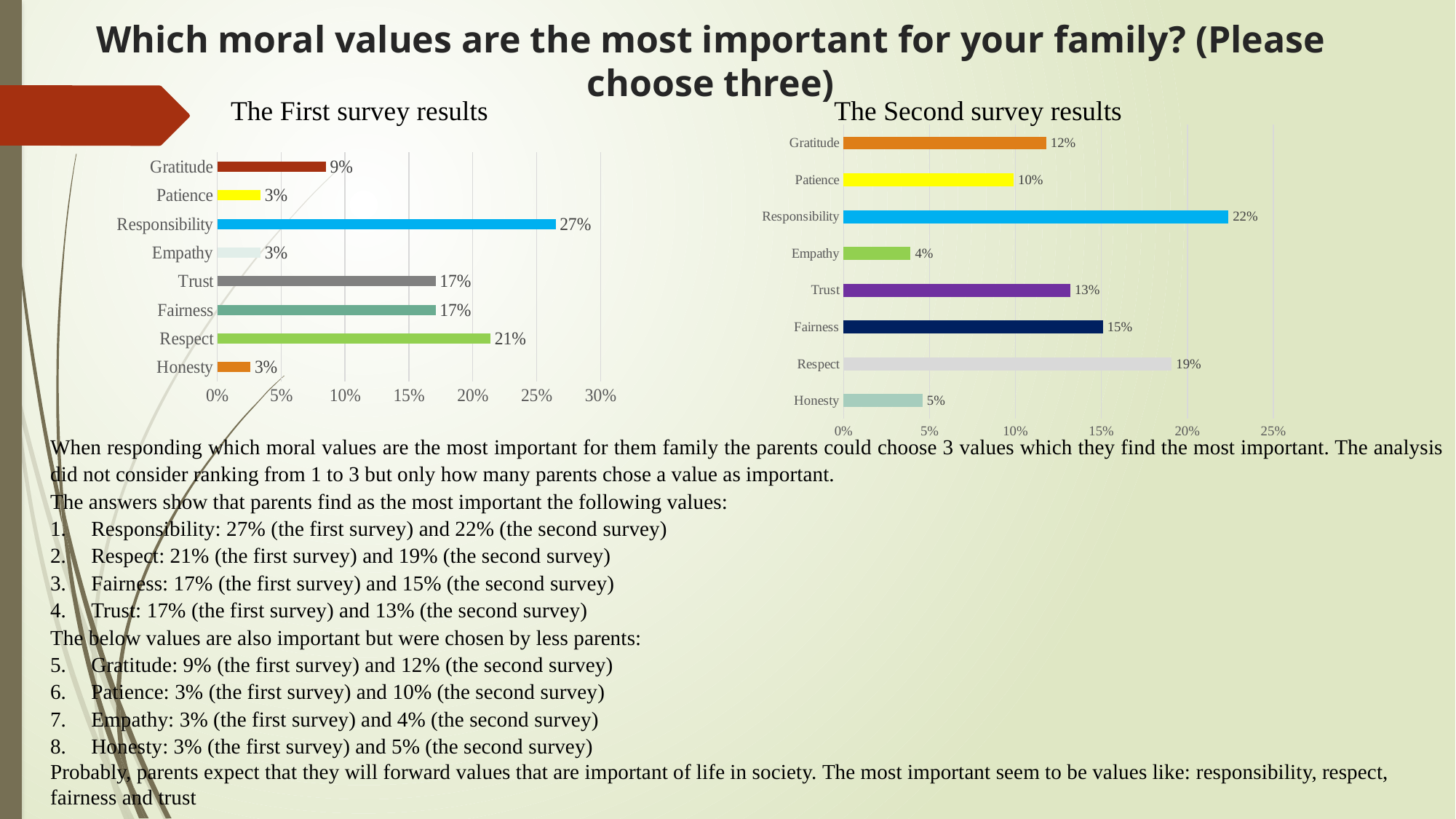
In the chart titled 'The First survey results', what is the difference between the values for Trust and Patience? 14% In the chart titled 'The Second survey results', which is larger, the value for Gratitude or the value for Patience? Gratitude In the chart titled 'The First survey results', which category has the highest value? Responsibility What kind of chart is 'The Second survey results'? Bar chart How many categories are shown in the chart titled 'The First survey results'? 8 In the chart titled 'The Second survey results', which category has the lowest value? Empathy In the chart titled 'The Second survey results', what is the value for Honesty? 5% In the chart titled 'The First survey results', what is the value for Responsibility? 27% In the chart titled 'The First survey results', what is the difference between the values for Responsibility and Respect? 6% In the chart titled 'The Second survey results', what is the value for Respect? 19% In the chart titled 'The Second survey results', is the value for Responsibility greater or less than 20%? greater In the chart titled 'The First survey results', what is the highest value shown on the x axis? 30%